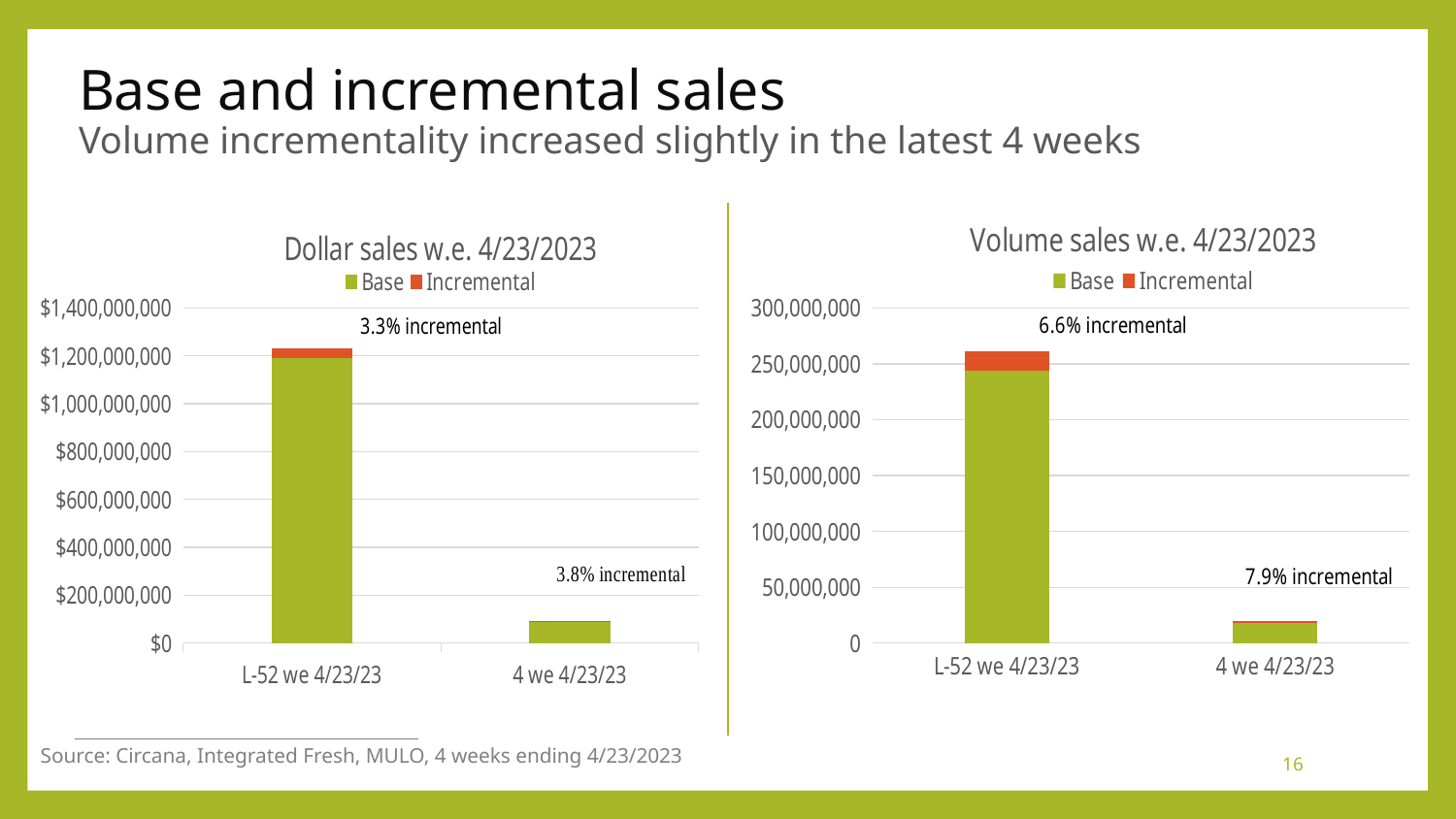
In the Volume sales w.e. 4/23/2023 chart, what incremental percentage is labelled for L-52 we 4/23/23? 6.6% incremental In the Volume sales w.e. 4/23/2023 chart, what incremental percentage is labelled for 4 we 4/23/23? 7.9% incremental In the Volume sales w.e. 4/23/2023 chart, is the total bar for 4 we 4/23/23 greater or less than 50,000,000? less In the Volume sales w.e. 4/23/2023 chart, which period has the taller bar? L-52 we 4/23/23 In the Dollar sales w.e. 4/23/2023 chart, is the total bar for 4 we 4/23/23 greater or less than $200,000,000? less In the Dollar sales w.e. 4/23/2023 chart, what incremental percentage is labelled for L-52 we 4/23/23? 3.3% incremental In the Dollar sales w.e. 4/23/2023 chart, what incremental percentage is labelled for 4 we 4/23/23? 3.8% incremental How many categories are shown on the x axis of the Dollar sales w.e. 4/23/2023 chart? 2 In the Volume sales w.e. 4/23/2023 chart, which colour represents the Incremental series? Orange In the Dollar sales w.e. 4/23/2023 chart, is the total bar for L-52 we 4/23/23 greater or less than $1,200,000,000? greater What type of chart is the Dollar sales w.e. 4/23/2023 chart? Stacked bar chart How many series does the legend of the Volume sales w.e. 4/23/2023 chart list? 2